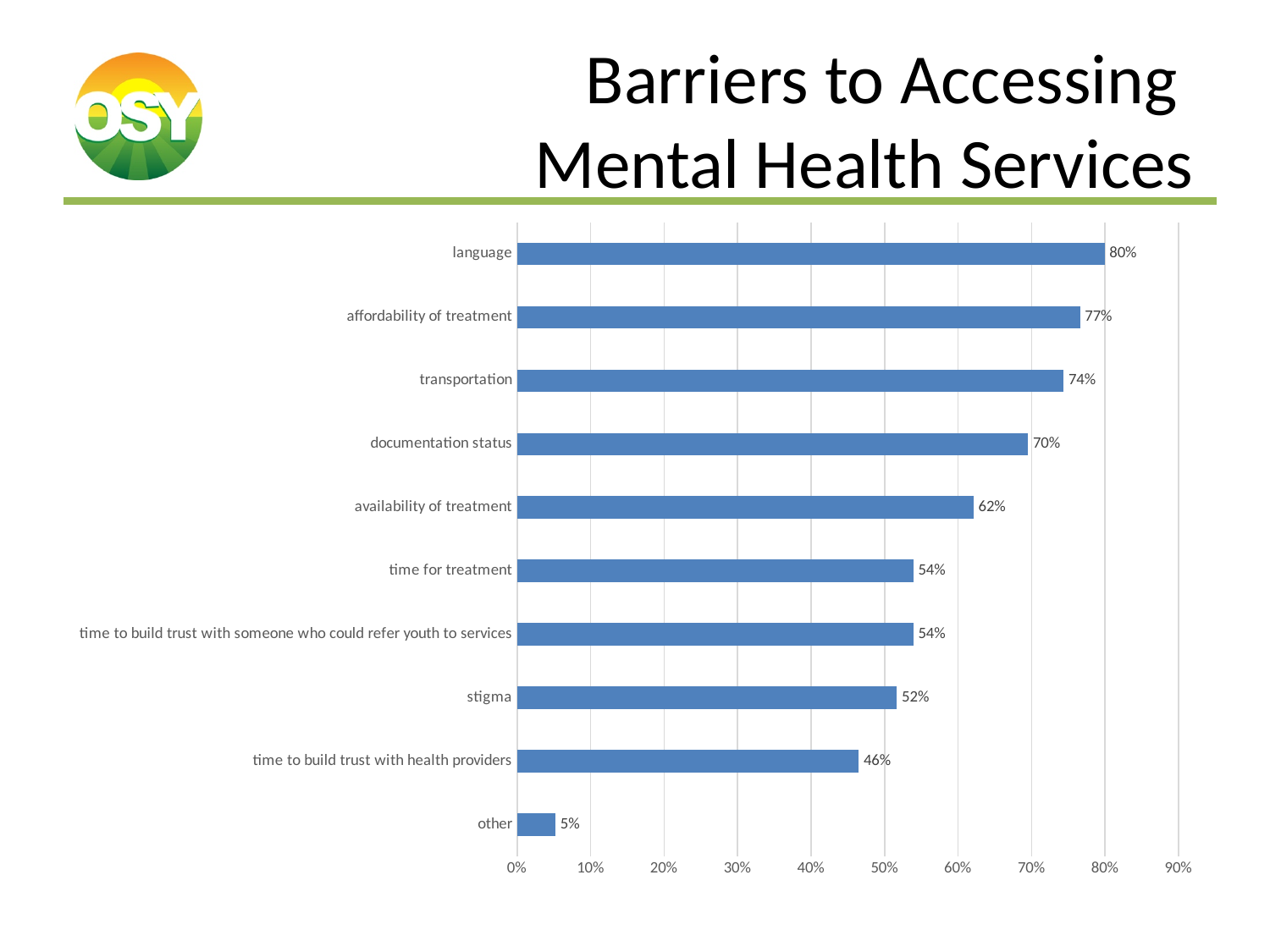
Which barrier has the lowest value? other What is the difference between the values for affordability of treatment and availability of treatment? 15% What is the value for language? 80% Which is larger, the value for transportation or the value for stigma? transportation Which barrier has the highest value? language What is the difference between the values for language and other? 75% What kind of chart is shown on the slide? bar chart What is the title of the slide? Barriers to Accessing Mental Health Services What is the value for time to build trust with health providers? 46% Is the value for time for treatment greater or less than 50%? greater What is the value for documentation status? 70% How many barriers are shown in the chart? 10